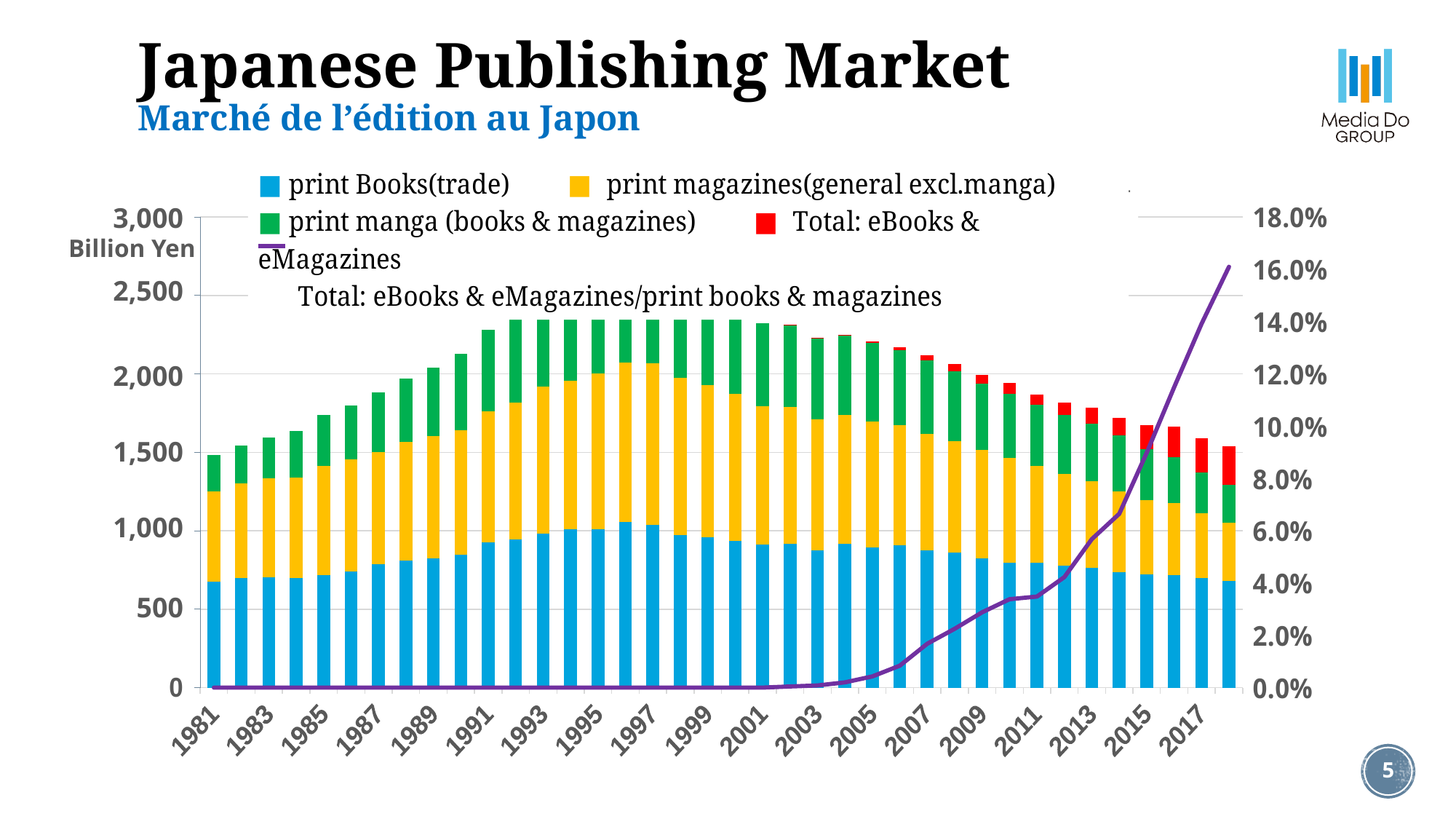
What kind of chart is shown on the slide? Stacked bar chart with a line overlay How many series does the legend list? 5 Is the eBooks & eMagazines share line value for 2018 greater or less than 14.0%? greater Is the eBooks & eMagazines share line value for 2009 greater or less than 4.0%? less Which colour represents print manga (books & magazines)? Green Does the total height of the stacked bars rise or fall from 2000 to 2018? Falls Is the total stacked bar for 1995 greater or less than 2,000? greater What unit is shown on the left vertical axis? Billion Yen Does the eBooks & eMagazines share line rise or fall from 2005 to 2018? Rises Which year has the larger total stacked bar, 1995 or 2018? 1995